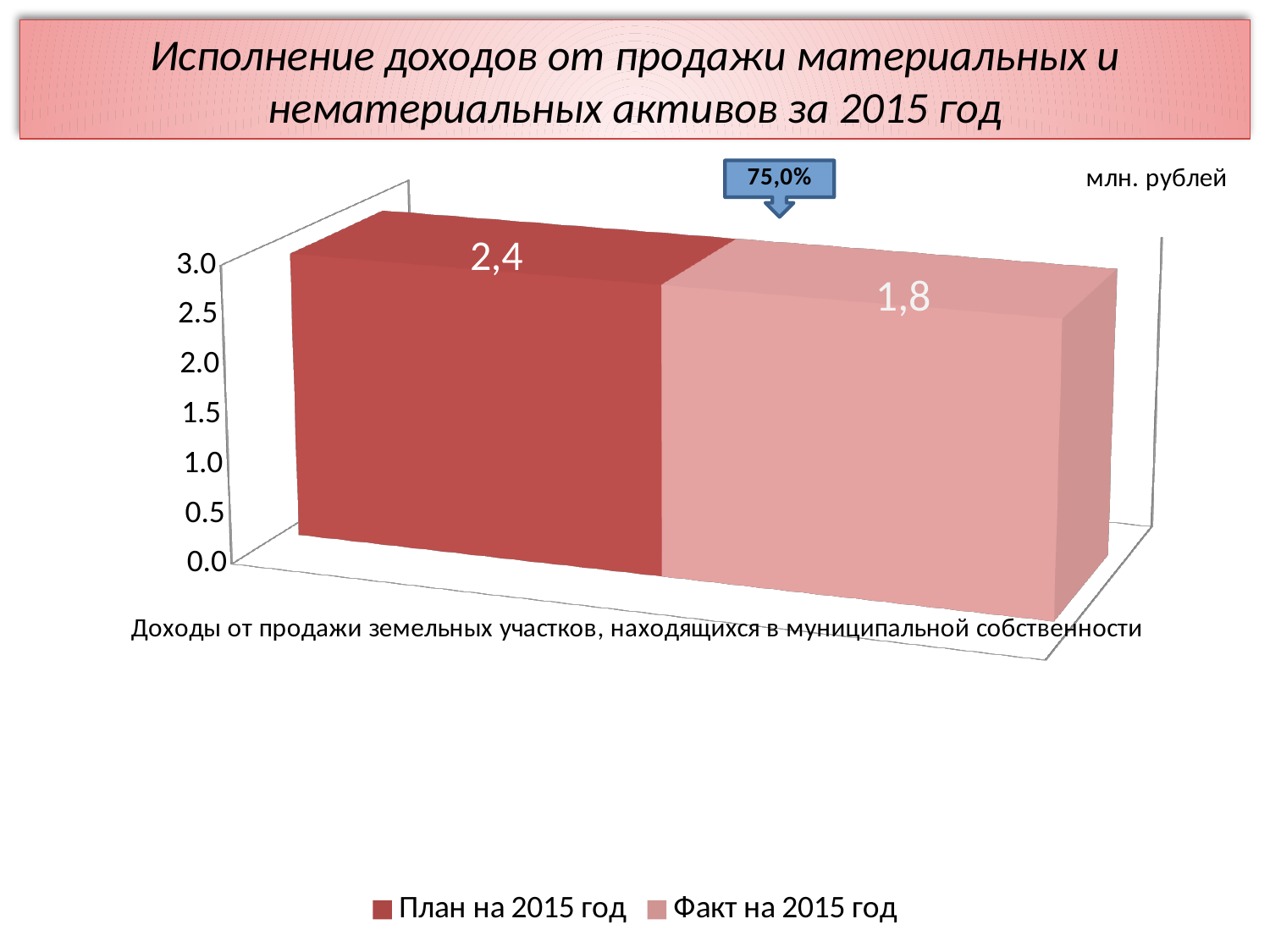
What unit is indicated for the chart values? млн. рублей What percentage is shown in the callout above the chart? 75,0% Is the value for План на 2015 год greater or less than 2.0? greater How many series does the legend list? 2 How many categories are shown on the x axis? 1 What kind of chart is shown on the slide? Bar chart What is the value for План на 2015 год? 2,4 What is the value for Факт на 2015 год? 1,8 What is the difference between the План на 2015 год value and the Факт на 2015 год value? 0,6 What is the maximum value shown on the vertical axis? 3.0 Which series has the higher value, План на 2015 год or Факт на 2015 год? План на 2015 год